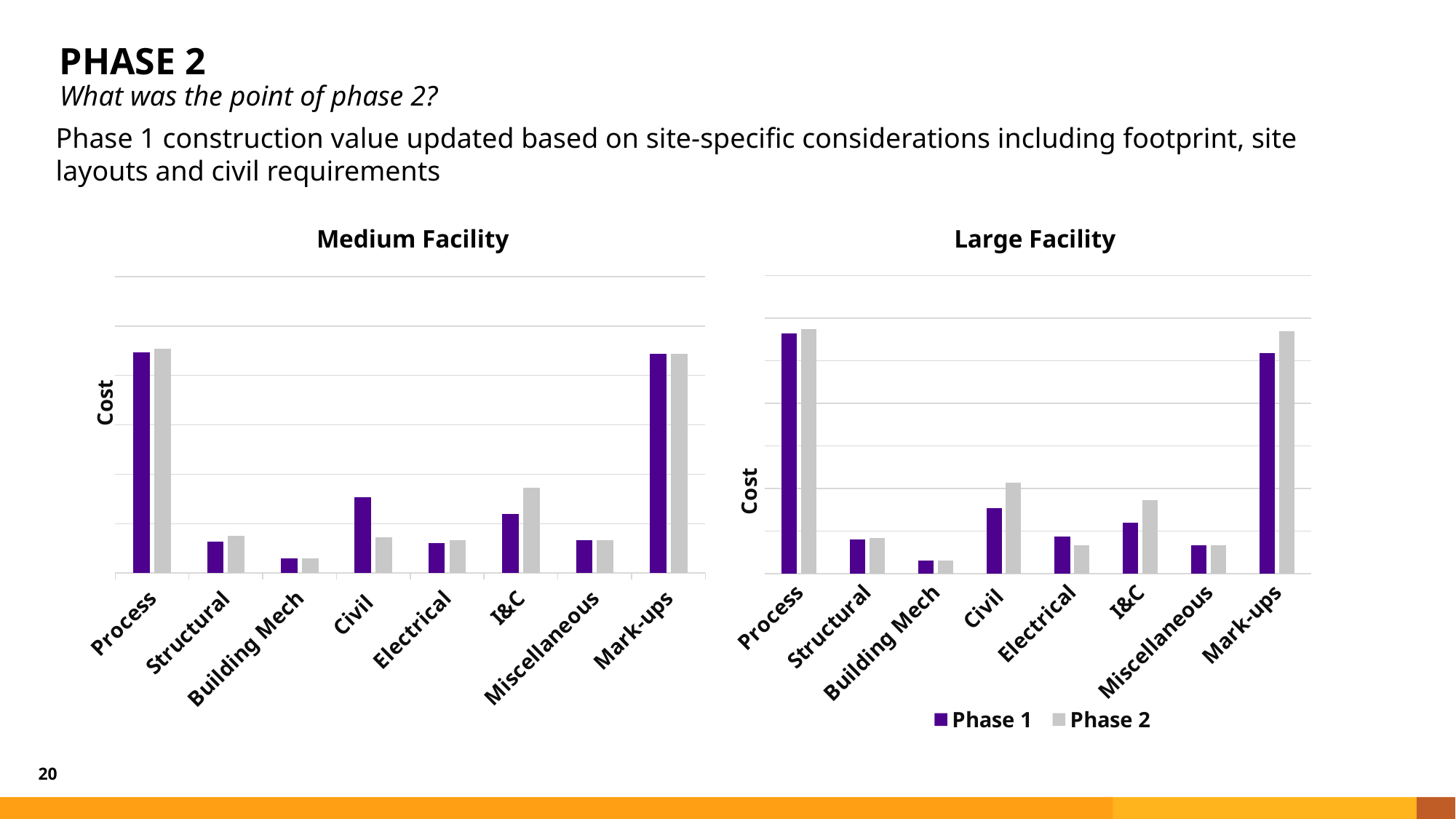
In the Large Facility chart, which category has the lowest cost for Phase 2? Building Mech In the Medium Facility chart, for I&C, is the Phase 1 or Phase 2 cost larger? Phase 2 How many categories are shown on the x axis of the Large Facility chart? 8 What is the label on the vertical axis of the Large Facility chart? Cost What kind of chart is the Medium Facility chart? bar chart In the Medium Facility chart, for Civil, is the Phase 1 or Phase 2 cost larger? Phase 1 In the Large Facility chart, for Electrical, is the Phase 1 or Phase 2 cost larger? Phase 1 How many series does the legend under the Large Facility chart list? 2 In the Large Facility chart, which category has the highest cost for Phase 1? Process In the Medium Facility chart, which category has the lowest cost for Phase 1? Building Mech Which series is shown in purple in the Large Facility chart's legend? Phase 1